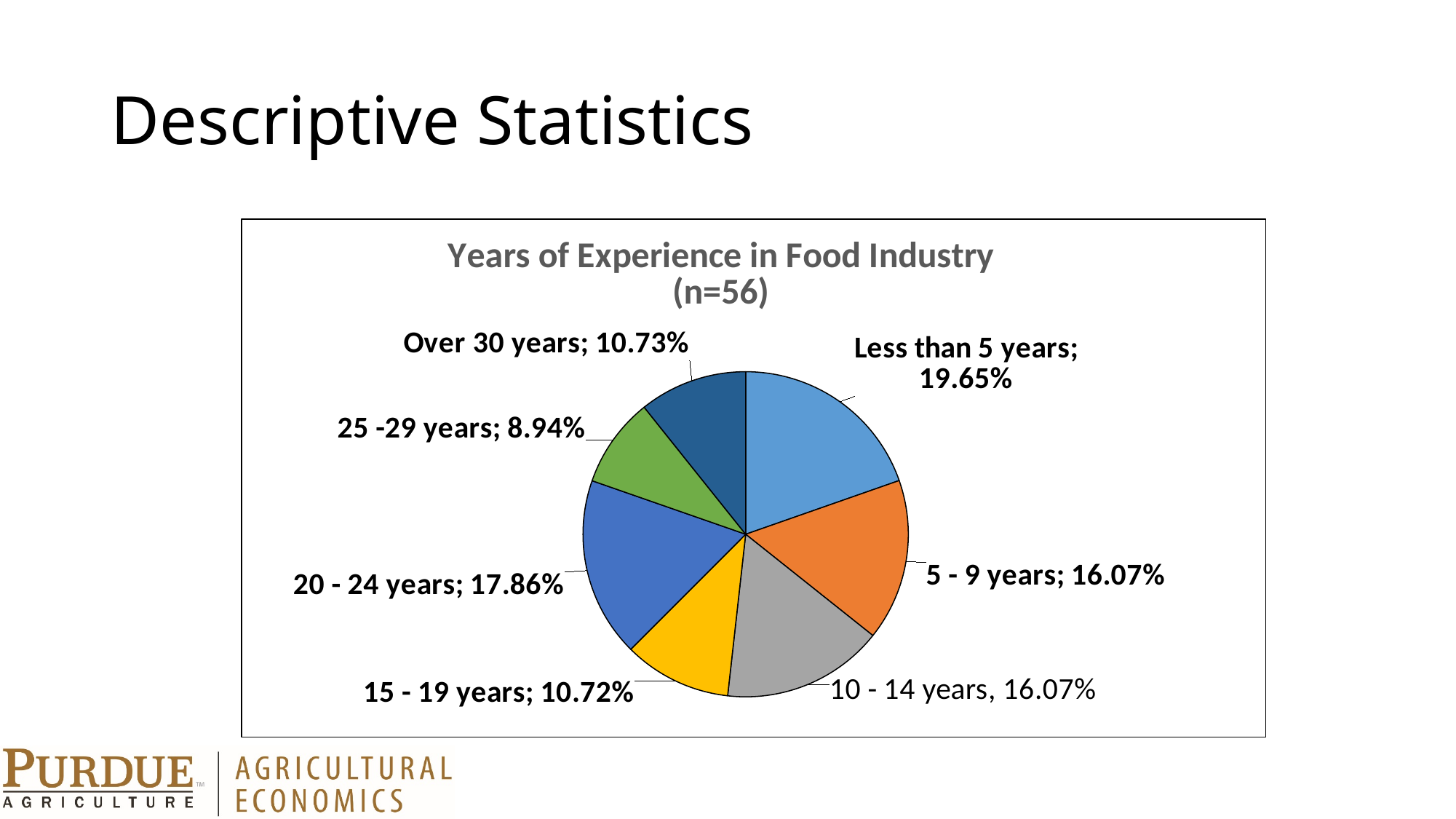
What percentage of respondents have 20 - 24 years of experience? 17.86% What is the title of the chart? Years of Experience in Food Industry (n=56) What percentage of respondents have over 30 years of experience? 10.73% What is the sample size (n) stated in the chart title? 56 What type of chart is shown on the slide? Pie chart What is the difference in percentage points between the 'Less than 5 years' slice and the '5 - 9 years' slice? 3.58 Which is larger: the share for 20 - 24 years or the share for 10 - 14 years? 20 - 24 years Which experience category has the smallest share of the pie? 25 -29 years How many experience categories are shown in the pie chart? 7 What share of respondents have less than 5 years of experience in the food industry? 19.65% What percentage of respondents have 25 -29 years of experience? 8.94% Which experience category has the largest share of the pie? Less than 5 years